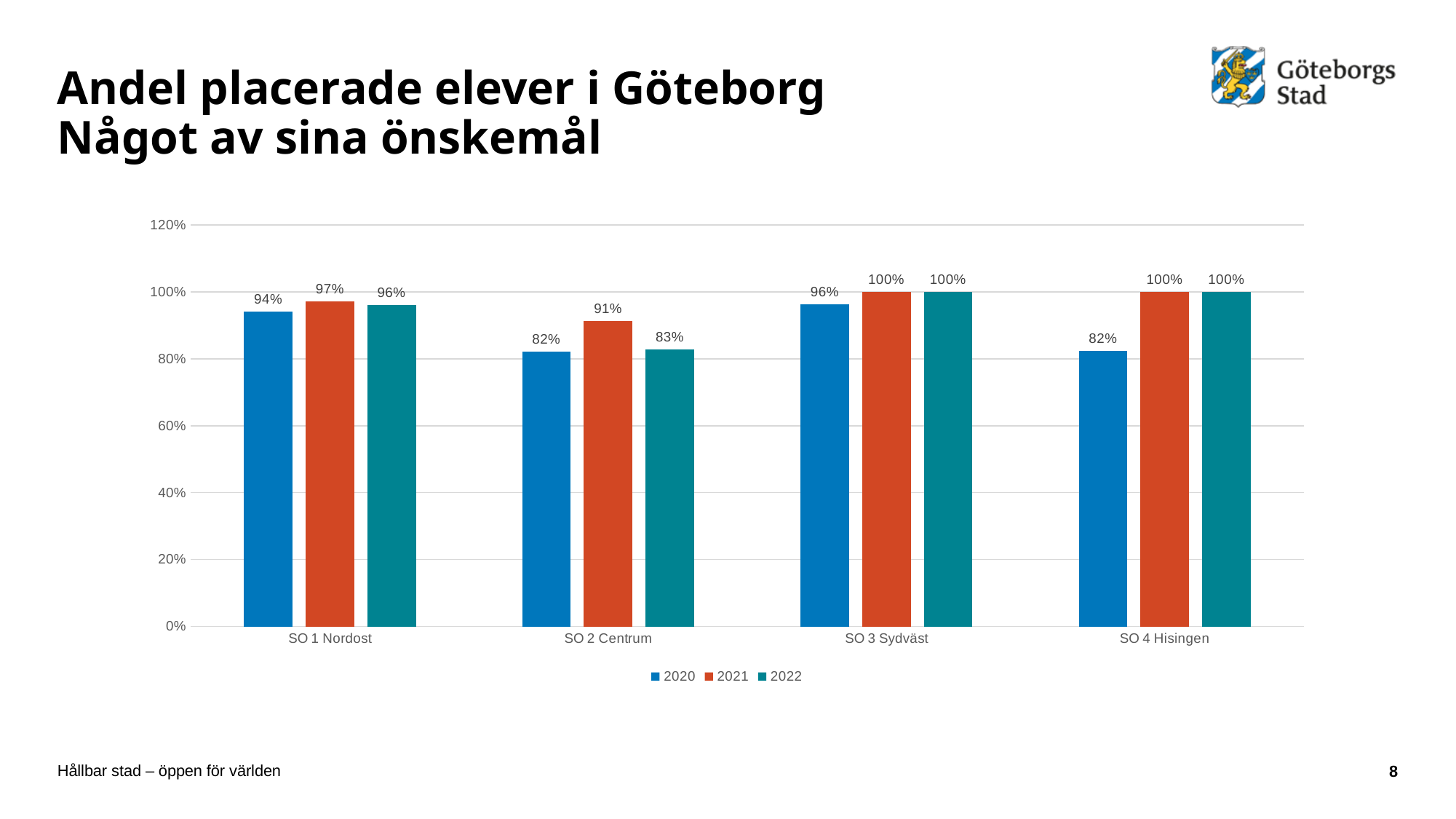
Which category has the highest value in 2020? SO 3 Sydväst What is the difference between the 2022 values for SO 3 Sydväst and SO 1 Nordost? 4% Which series is shown in orange in the legend? 2021 How many categories are shown on the x axis? 4 Which is larger: the 2021 value for SO 1 Nordost or the 2021 value for SO 2 Centrum? SO 1 Nordost What is the difference between the 2021 and 2020 values for SO 2 Centrum? 9% What is the value for SO 1 Nordost in 2022? 96% Which category has the lowest value in 2022? SO 2 Centrum What is the value for SO 2 Centrum in 2021? 91% How many series does the legend list? 3 What is the value for SO 4 Hisingen in 2020? 82% What kind of chart is shown on the slide? Bar chart